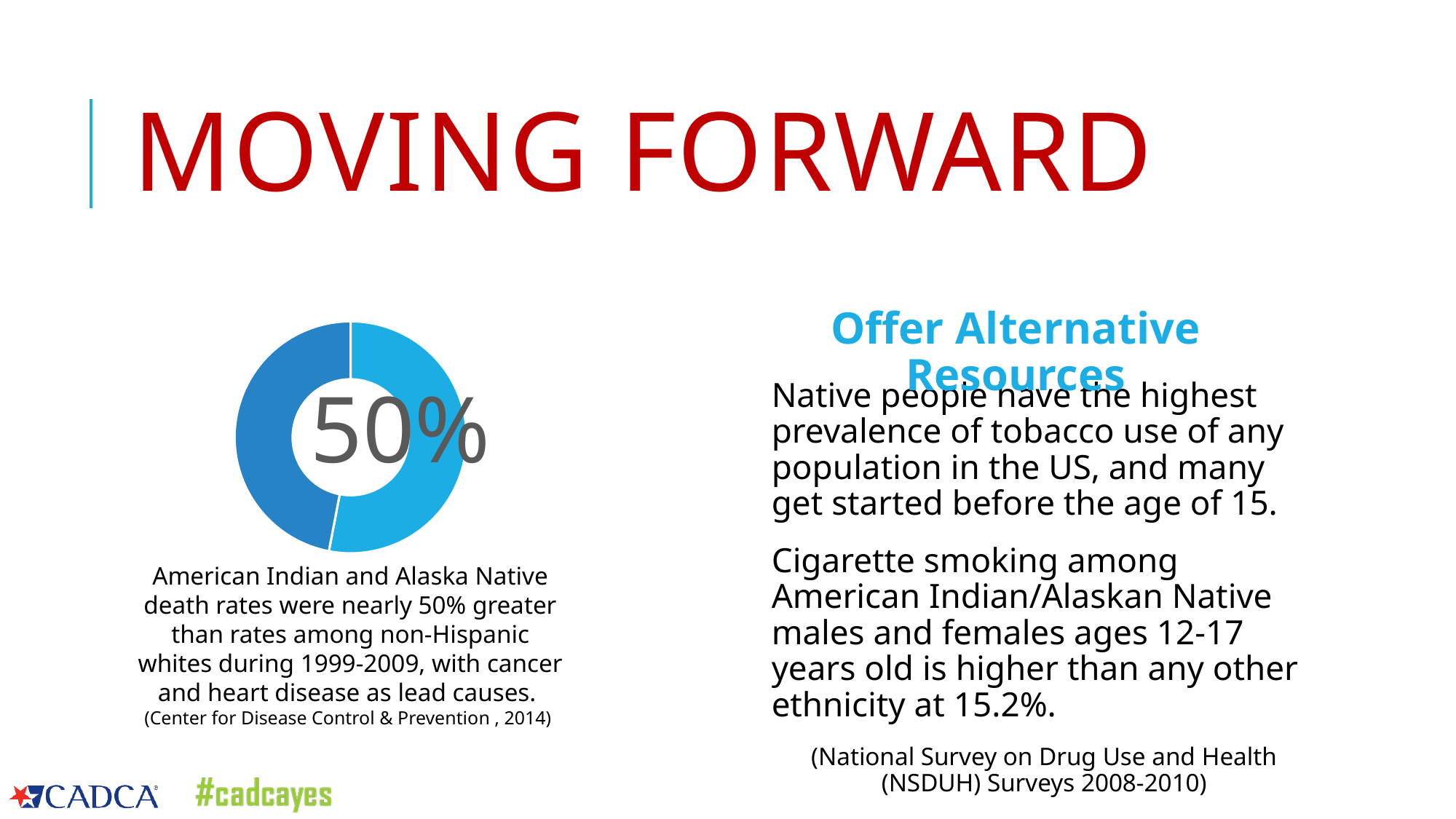
What value is printed in the centre of the donut chart? 50% What two colours are used for the slices of the donut chart? Light blue and dark blue According to the caption under the donut chart, which source is cited for the 50% figure? Center for Disease Control & Prevention, 2014 Does the donut chart include a legend? No What kind of chart is shown on the left of the slide? Donut (pie) chart According to the caption under the donut chart, during which years were American Indian and Alaska Native death rates nearly 50% greater than rates among non-Hispanic whites? 1999-2009 How many slices does the donut chart have? 2